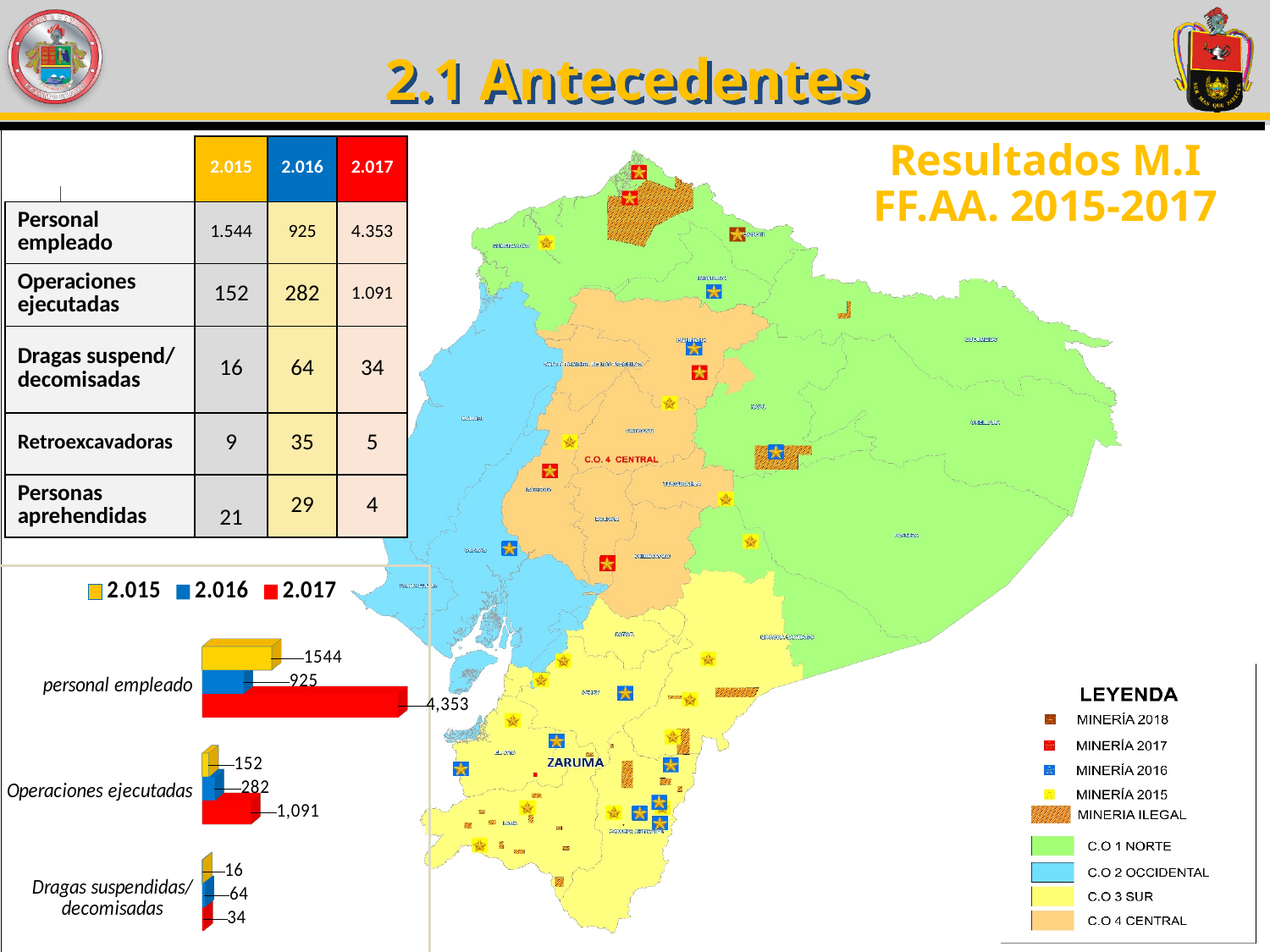
In the bar chart, which is larger for Dragas suspendidas/decomisadas: the 2.016 value or the 2.017 value? 2.016 How many categories are plotted in the bar chart? 3 How many series does the legend of the bar chart list? 3 In the bar chart, what is the difference between the 2.017 and 2.016 values for Operaciones ejecutadas? 809 In the bar chart, which series has the lowest value for Dragas suspendidas/decomisadas? 2.015 In the bar chart, what is the value for Dragas suspendidas/decomisadas in the 2.016 series? 64 Which colour represents the 2.017 series in the bar chart legend? red In the bar chart, which series has the highest value for personal empleado? 2.017 What kind of chart is shown at the bottom left of the slide? bar chart In the bar chart, what is the value for Operaciones ejecutadas in the 2.017 series? 1,091 In the bar chart, what is the value for personal empleado in the 2.016 series? 925 In the bar chart, what is the value for personal empleado in the 2.017 series? 4,353